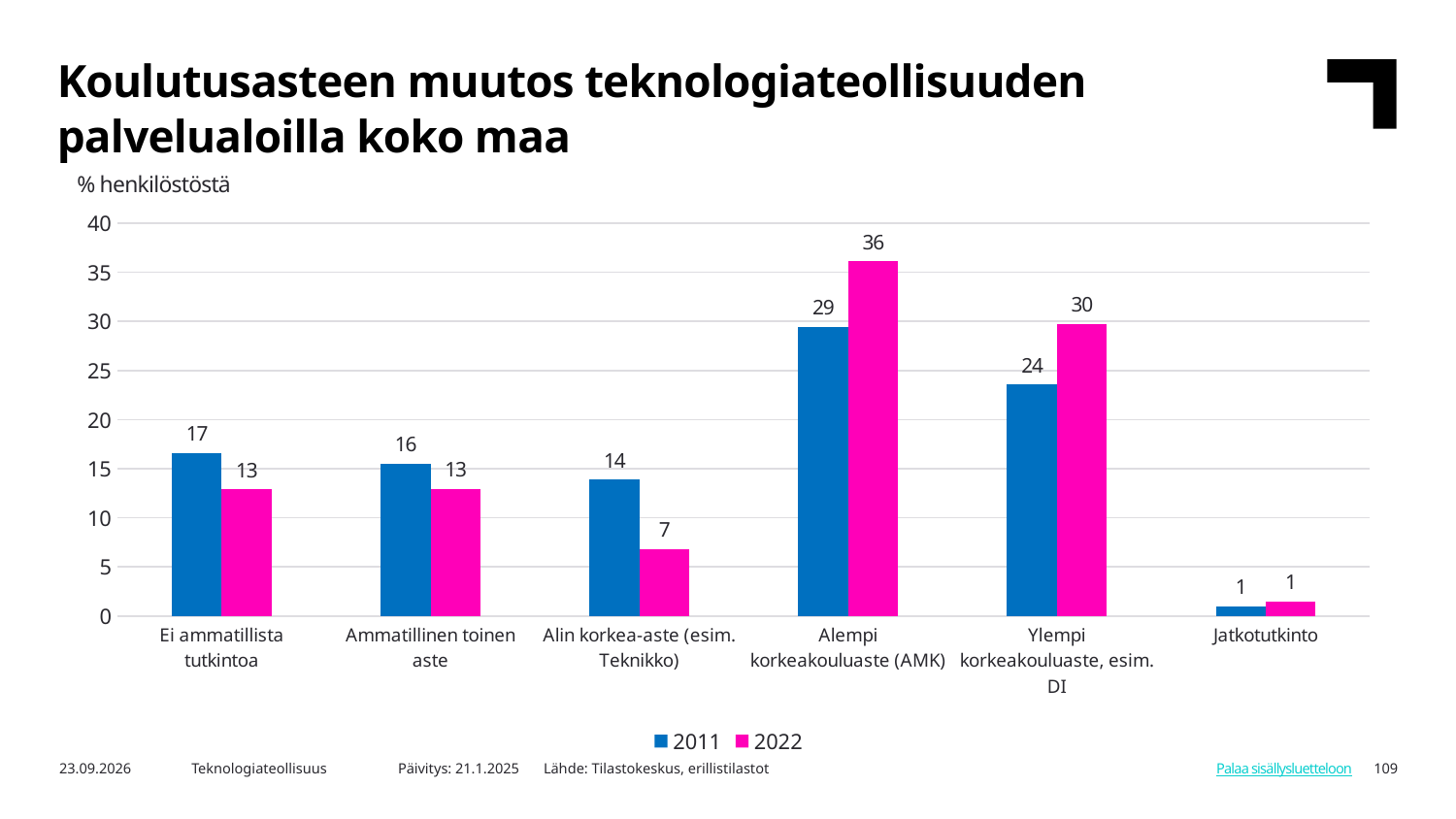
What is the difference between the 2011 and 2022 values for Alin korkea-aste (esim. Teknikko)? 7 What kind of chart is shown on the slide? Bar chart What is the 2022 value for Alempi korkeakouluaste (AMK)? 36 Which category has the lowest 2011 value? Jatkotutkinto Which is larger for Ylempi korkeakouluaste, esim. DI: the 2011 value or the 2022 value? 2022 What is the difference between the 2022 and 2011 values for Alempi korkeakouluaste (AMK)? 7 How many series does the legend list? 2 Which category has the highest 2022 value? Alempi korkeakouluaste (AMK) How many categories are shown on the x axis? 6 What is the 2022 value for Alin korkea-aste (esim. Teknikko)? 7 What unit is shown above the chart's y axis? % henkilöstöstä What is the 2011 value for Ei ammatillista tutkintoa? 17